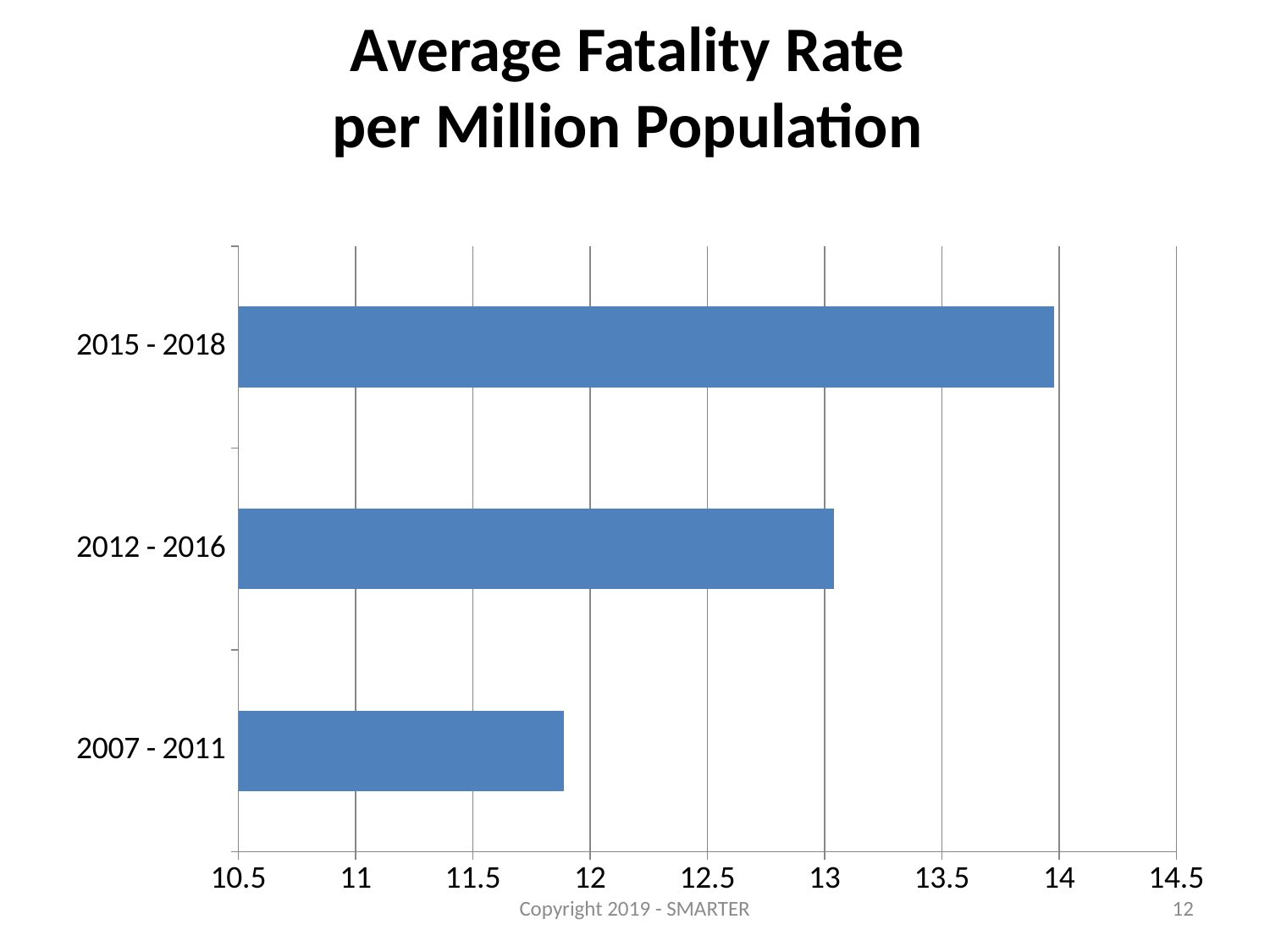
Is the value for 2012 - 2016 greater or less than 12.5? greater How many time periods are plotted in the chart? 3 Which time period has the highest average fatality rate? 2015 - 2018 Which time period has the lowest average fatality rate? 2007 - 2011 Is the value for 2007 - 2011 greater or less than 12? less Which has a larger average fatality rate, 2015 - 2018 or 2012 - 2016? 2015 - 2018 What is the title of the chart? Average Fatality Rate per Million Population Which has a larger average fatality rate, 2007 - 2011 or 2012 - 2016? 2012 - 2016 Does the average fatality rate rise or fall from the 2007 - 2011 period to the 2015 - 2018 period? rise Is the value for 2015 - 2018 greater or less than 13.5? greater What type of chart is shown on the slide? bar chart